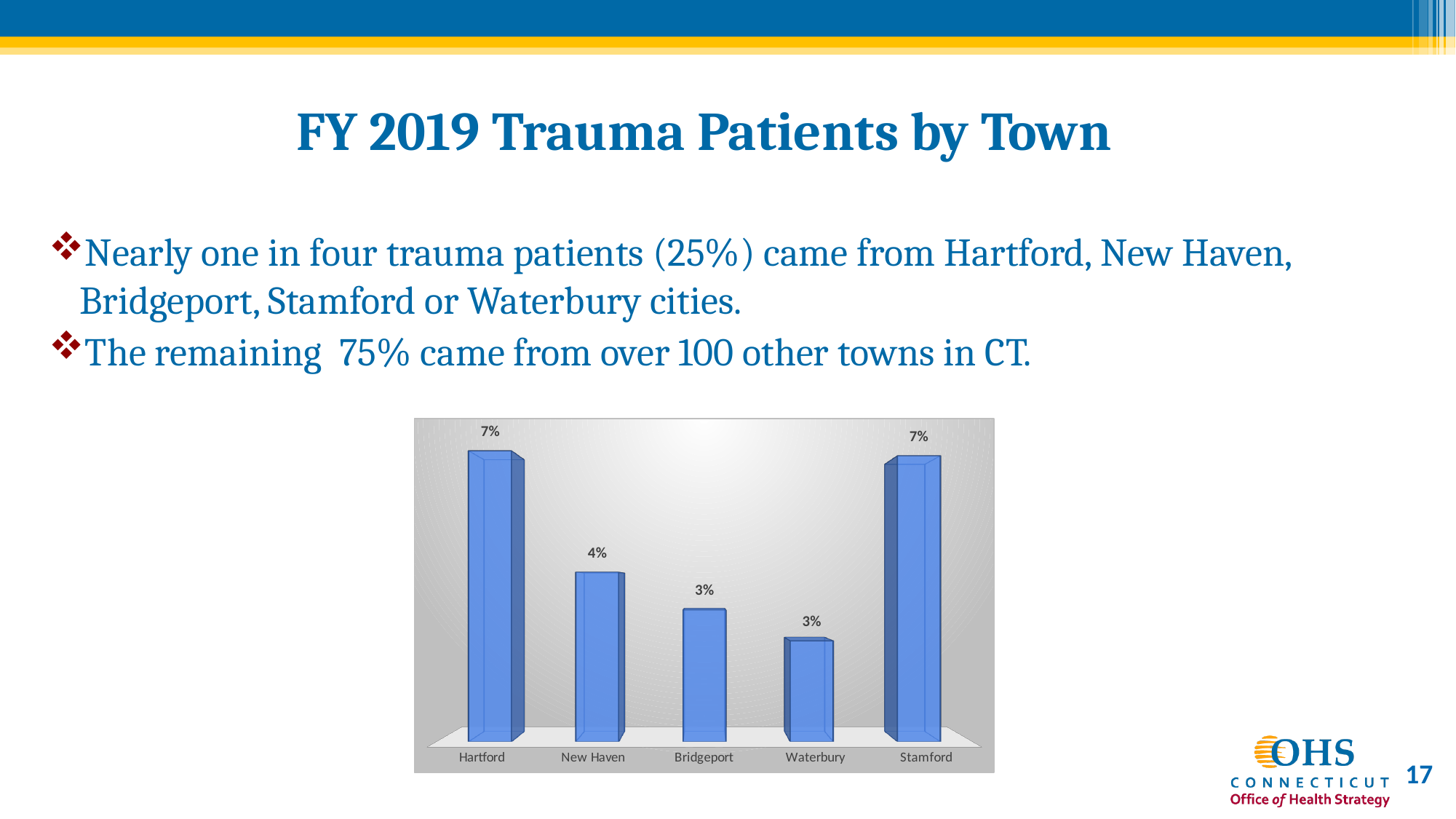
What percentage of trauma patients came from Hartford? 7% Which two towns share the lowest value in the chart? Bridgeport and Waterbury Do the values rise or fall from Hartford to Waterbury along the x axis? Fall What kind of chart is shown on the slide? Bar chart What is the difference between the values for Stamford and Waterbury? 4% Which has a larger value, New Haven or Bridgeport? New Haven What is the value shown for Stamford? 7% What is the value shown for Bridgeport? 3% What percentage of trauma patients came from New Haven? 4% Which two towns share the highest value in the chart? Hartford and Stamford How many towns are shown in the chart? 5 What is the difference between the values for Hartford and New Haven? 3%